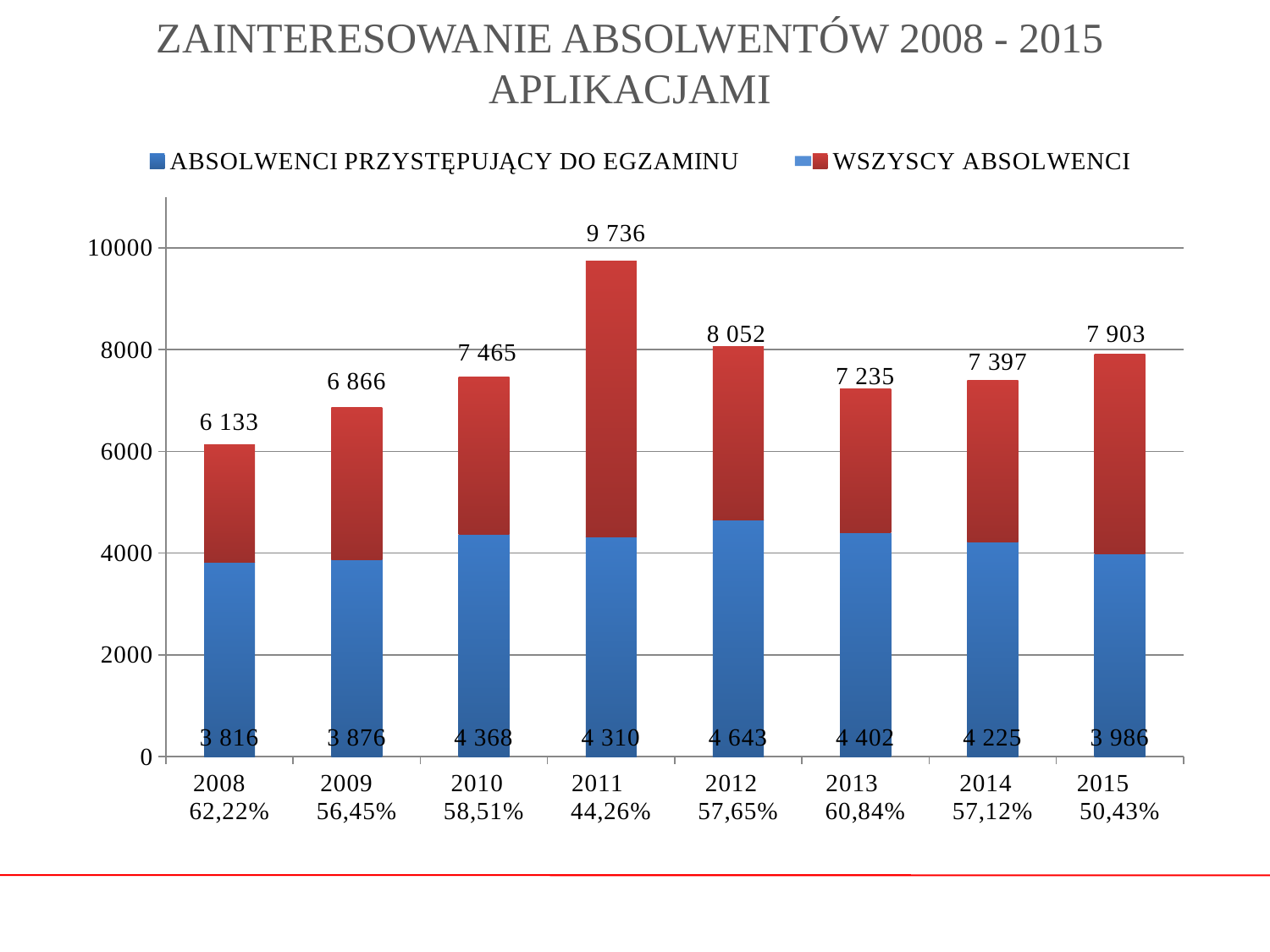
Which year has the lowest ABSOLWENCI PRZYSTĘPUJĄCY DO EGZAMINU value? 2008 Which year has the lowest WSZYSCY ABSOLWENCI value? 2008 Which year has the highest WSZYSCY ABSOLWENCI value? 2011 What is the ABSOLWENCI PRZYSTĘPUJĄCY DO EGZAMINU value shown for 2012? 4 643 What is the difference between the WSZYSCY ABSOLWENCI values for 2012 and 2013? 817 Which is larger, the ABSOLWENCI PRZYSTĘPUJĄCY DO EGZAMINU value for 2010 or for 2014? 2010 What kind of chart is shown on the slide? bar chart How many years are shown on the x axis? 8 What percentage is shown under the 2011 category label? 44,26% Is the WSZYSCY ABSOLWENCI value for 2009 greater or less than 8000? less What is the WSZYSCY ABSOLWENCI value shown for 2011? 9 736 How many series does the legend list? 2